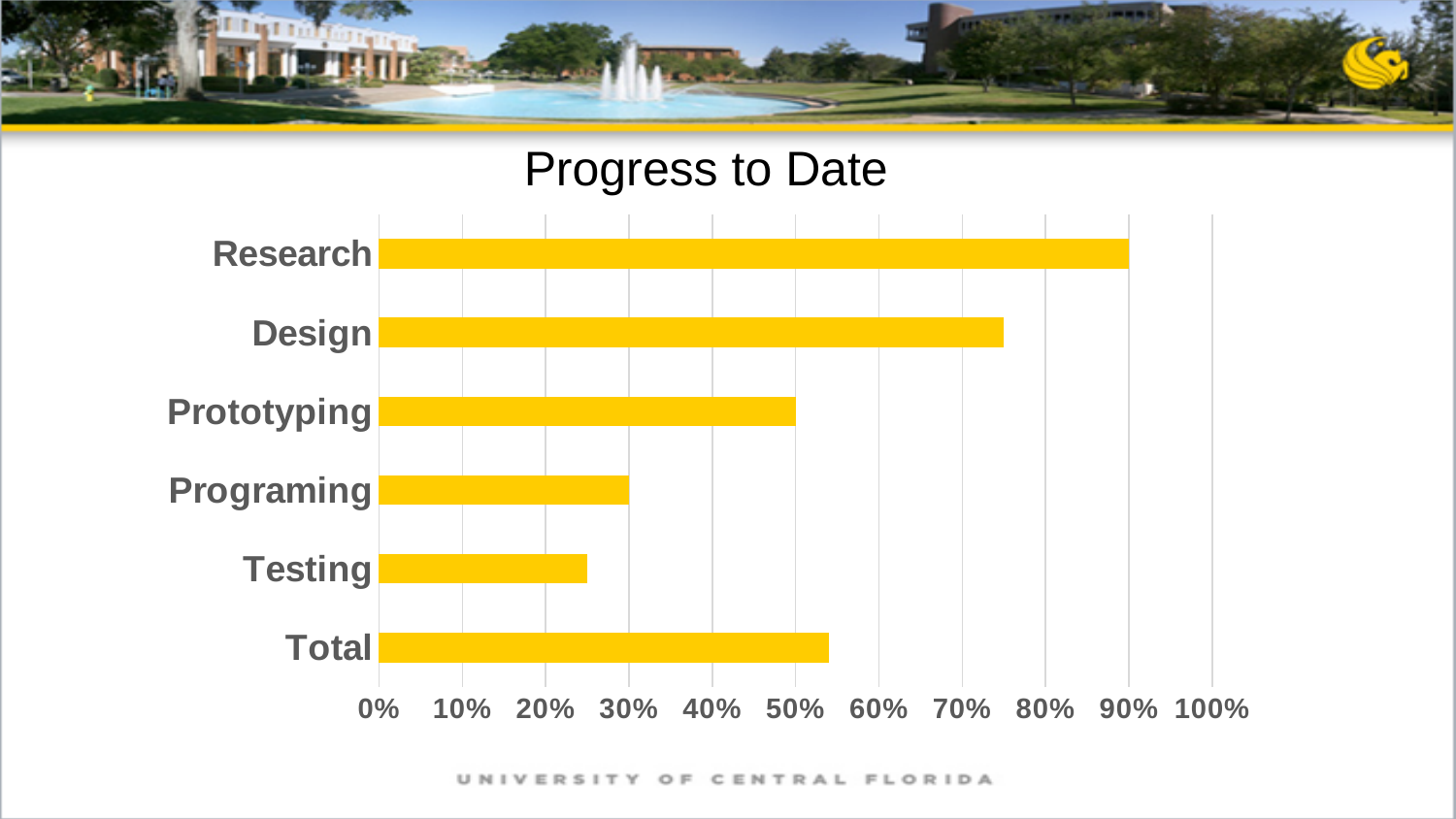
What is the value for Programing? 30% Is the value for Testing greater or less than 30%? less What is the value for Prototyping? 50% Is the value for Total greater or less than 50%? greater How many categories are shown on the chart? 6 Which category has the lowest value? Testing Which is larger, the value for Design or the value for Prototyping? Design What is the title of the chart? Progress to Date What is the value for Research? 90% What kind of chart is shown on the slide? bar chart Is the value for Design greater or less than 70%? greater Which category has the highest value? Research